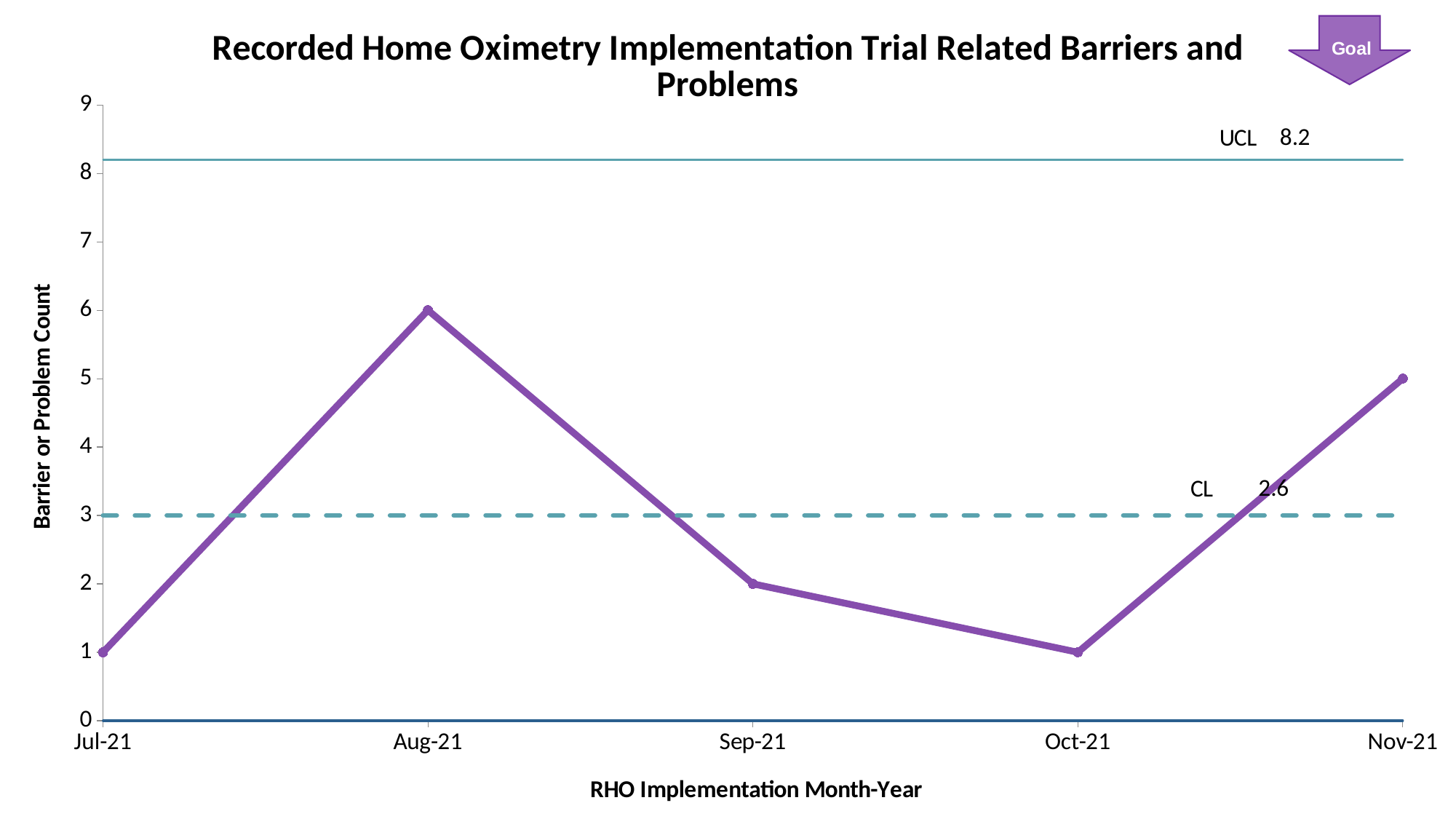
What is the difference between the Barrier or Problem Count in Aug-21 and Sep-21? 4 What is the Barrier or Problem Count for Sep-21? 2 Which month has the highest Barrier or Problem Count? Aug-21 What type of chart is shown on the slide? line chart What value is labelled for the UCL line? 8.2 What value is labelled for the CL line? 2.6 Does the Barrier or Problem Count rise or fall from Aug-21 to Oct-21? fall How many months are plotted on the x axis? 5 Which is larger, the Barrier or Problem Count for Nov-21 or for Sep-21? Nov-21 What is the Barrier or Problem Count for Aug-21? 6 What is the Barrier or Problem Count for Nov-21? 5 What is the title of the chart? Recorded Home Oximetry Implementation Trial Related Barriers and Problems